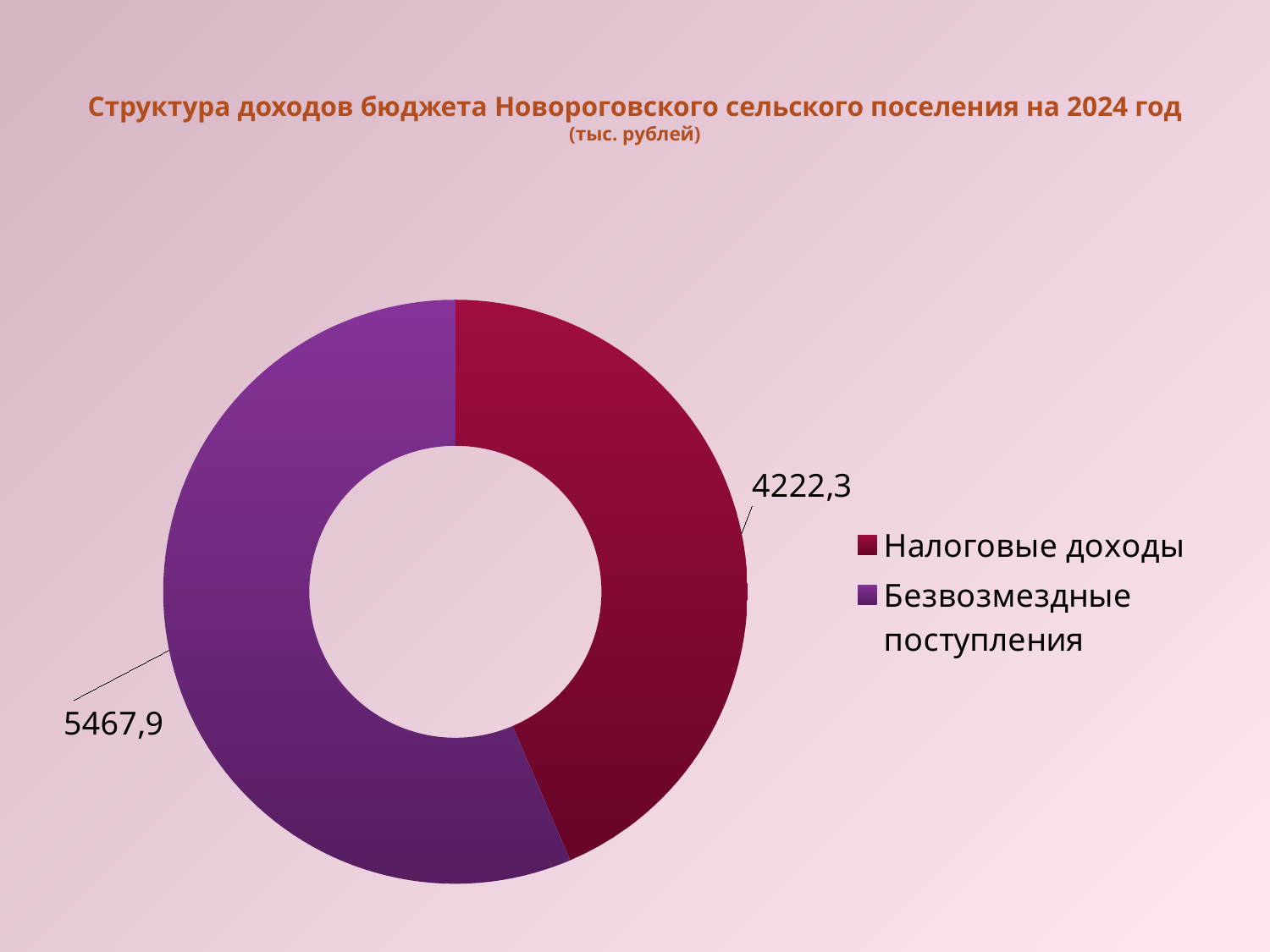
What is the difference between Безвозмездные поступления and Налоговые доходы? 1245,6 What colour is the slice for Налоговые доходы? Dark red How many categories does the chart show? 2 What is the value for Безвозмездные поступления? 5467,9 Which category has the largest value? Безвозмездные поступления What kind of chart is shown on the slide? Doughnut (pie) chart What is the total of the two categories shown in the chart? 9690,2 What is the title of the chart? Структура доходов бюджета Новороговского сельского поселения на 2024 год (тыс. рублей) What is the value for Налоговые доходы? 4222,3 How many entries does the legend list? 2 Which category has the smallest value? Налоговые доходы Which is larger, Налоговые доходы or Безвозмездные поступления? Безвозмездные поступления